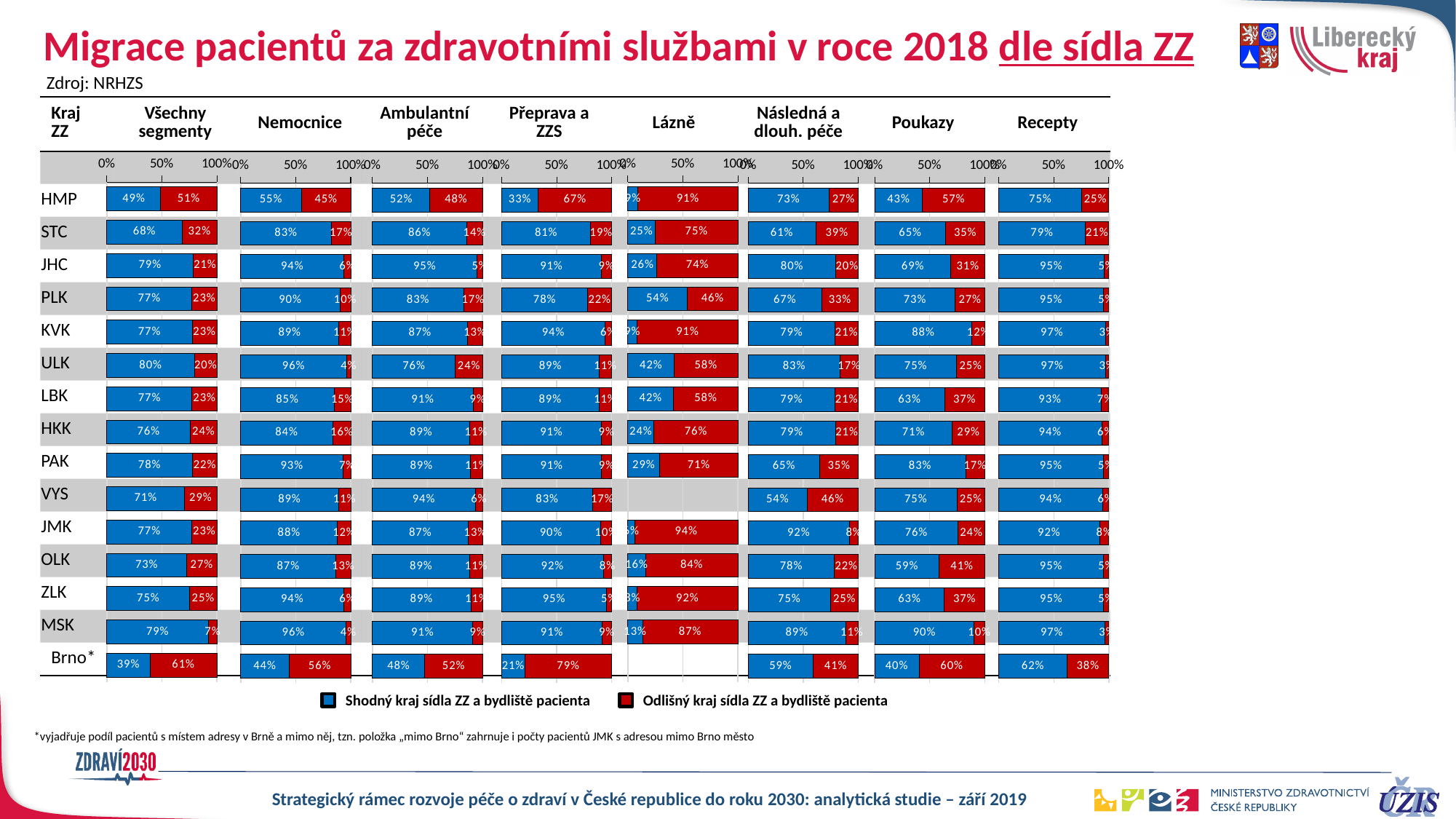
How many series does the legend list? 2 In the "Nemocnice" chart, which row has the lowest blue share? Brno* What kind of chart is used for each segment on the slide? Stacked bar chart Which colour represents "Odlišný kraj sídla ZZ a bydliště pacienta" in the legend? Red In the "Lázně" chart, which region has the highest blue share (same region of residence)? PLK In the "Recepty" chart, what is the blue share for Brno*? 62% In the "Poukazy" chart, what is the difference between the blue share for MSK and the blue share for OLK? 31 percentage points In the "Přeprava a ZZS" chart, which is larger: the blue share for ZLK or the blue share for HMP? ZLK In the "Lázně" chart, what is the share of patients from a different region (red) for HMP? 91% In the "Následná a dlouh. péče" chart, what is the total of the VYS bar (54% + 46%)? 100% In the "Všechny segmenty" chart, what is the share of patients with the same region of residence (blue) for LBK? 77% How many rows (regions including Brno*) are plotted in the "Ambulantní péče" chart? 15